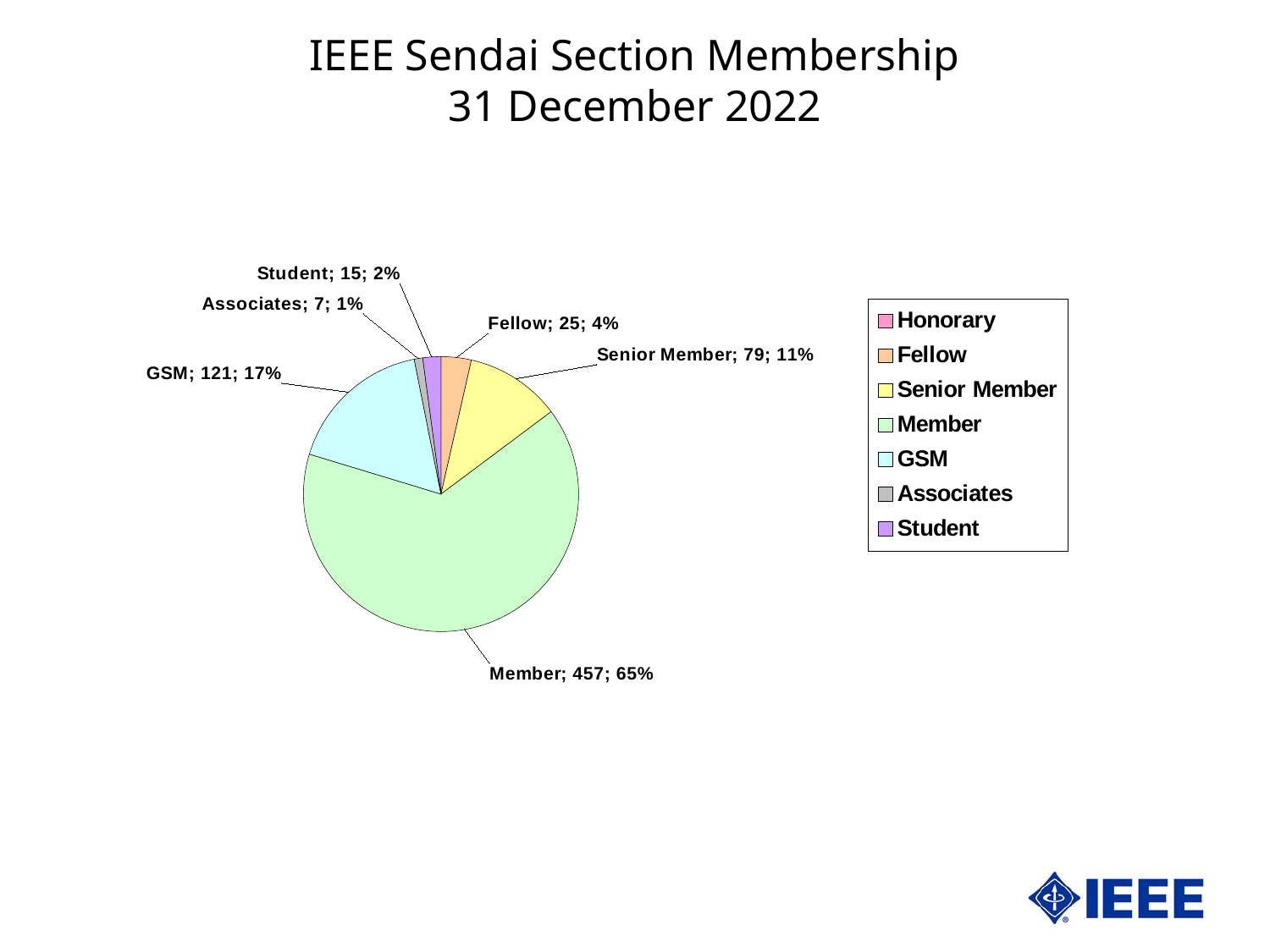
What colour is the Member slice of the pie? light green What kind of chart is shown on the slide? pie chart What percentage of the membership is GSM? 17% What share of the pie does the Fellow slice represent? 4% Which category has the largest slice of the pie? Member How many entries does the legend list? 7 How many members are in the Member category? 457 What is the title of the chart on the slide? IEEE Sendai Section Membership 31 December 2022 Which labelled category has the smallest slice of the pie? Associates Which is larger, the Student count or the Fellow count? Fellow What is the difference between the number of GSM members and the number of Senior Members? 42 How many Senior Members are shown? 79